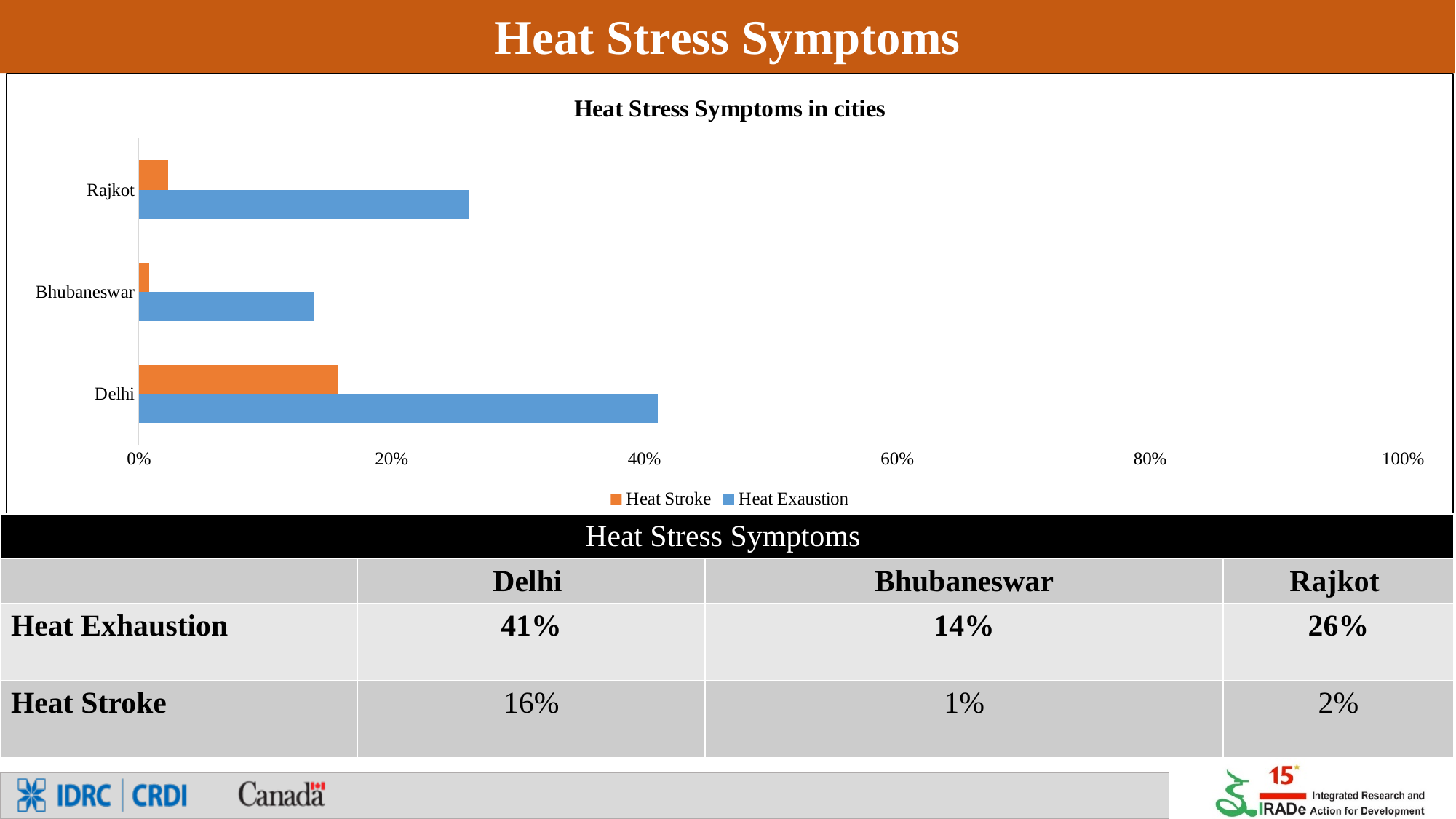
What is the difference between the Heat Exhaustion values for Delhi and Bhubaneswar? 27% How many series does the chart legend list? 2 Which city has the lowest Heat Stroke value? Bhubaneswar What kind of chart is shown on the slide? bar chart Which city has the highest Heat Exhaustion value? Delhi How many cities are shown on the chart? 3 What is the Heat Exhaustion value for Delhi? 41% What is the Heat Exhaustion value for Rajkot? 26% Is the Heat Exhaustion value for Delhi greater or less than 40%? greater What is the title of the chart? Heat Stress Symptoms in cities What is the Heat Stroke value for Bhubaneswar? 1% Which is larger, the Heat Stroke value for Delhi or for Rajkot? Delhi